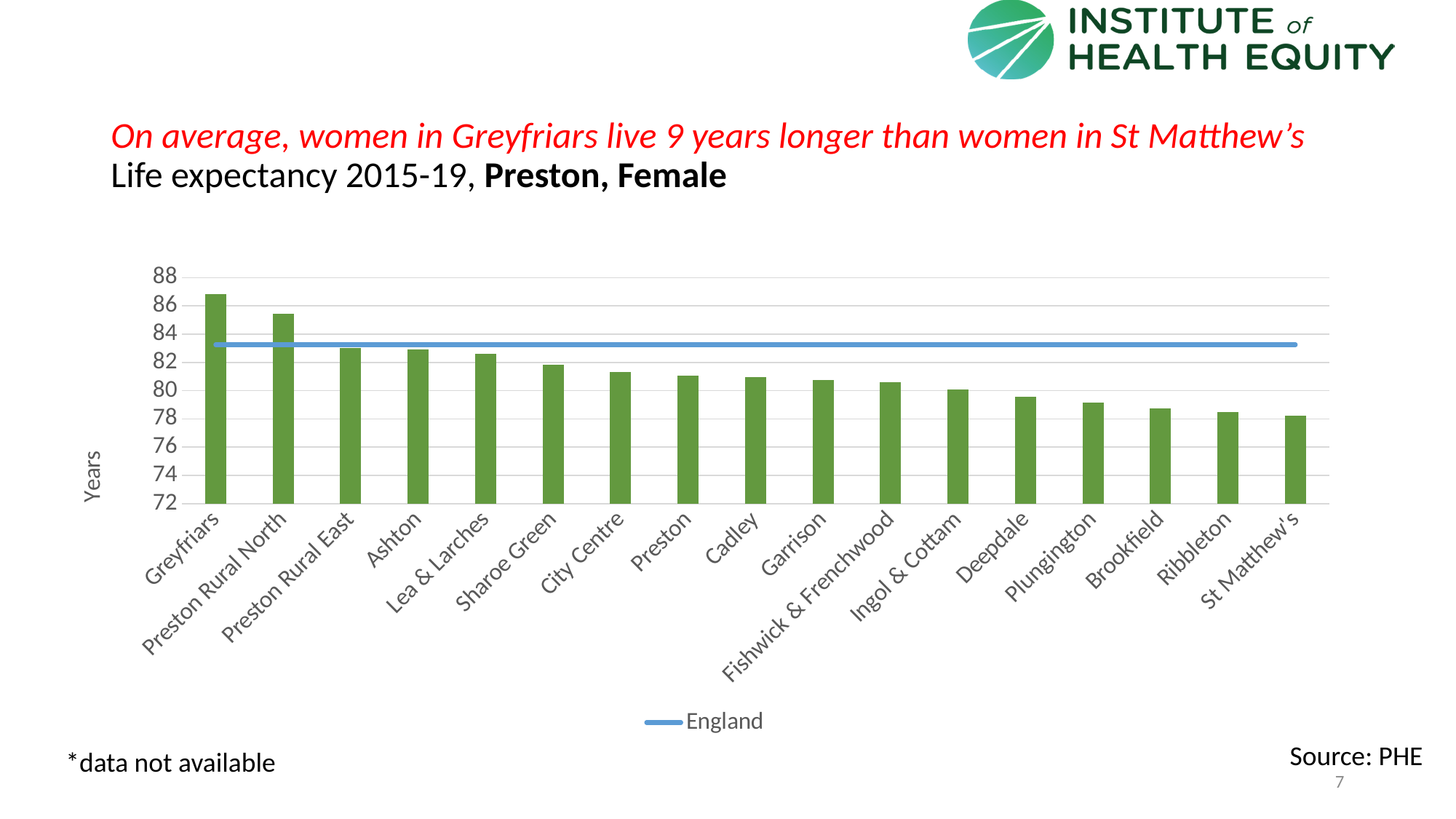
Is the value for Plungington greater or less than 80? less How many wards are shown as bars on the chart? 17 Which is larger, the value for Deepdale or the value for Ribbleton? Deepdale Which ward has the lowest female life expectancy on the chart? St Matthew's Which ward has the highest female life expectancy on the chart? Greyfriars Is the value for St Matthew's greater or less than 80? less Which is larger, the value for Greyfriars or the value for Preston Rural North? Greyfriars Do the bar values rise or fall from left to right along the x axis? Fall Is the value for Sharoe Green greater or less than 80? greater What kind of chart is shown on the slide? Bar chart